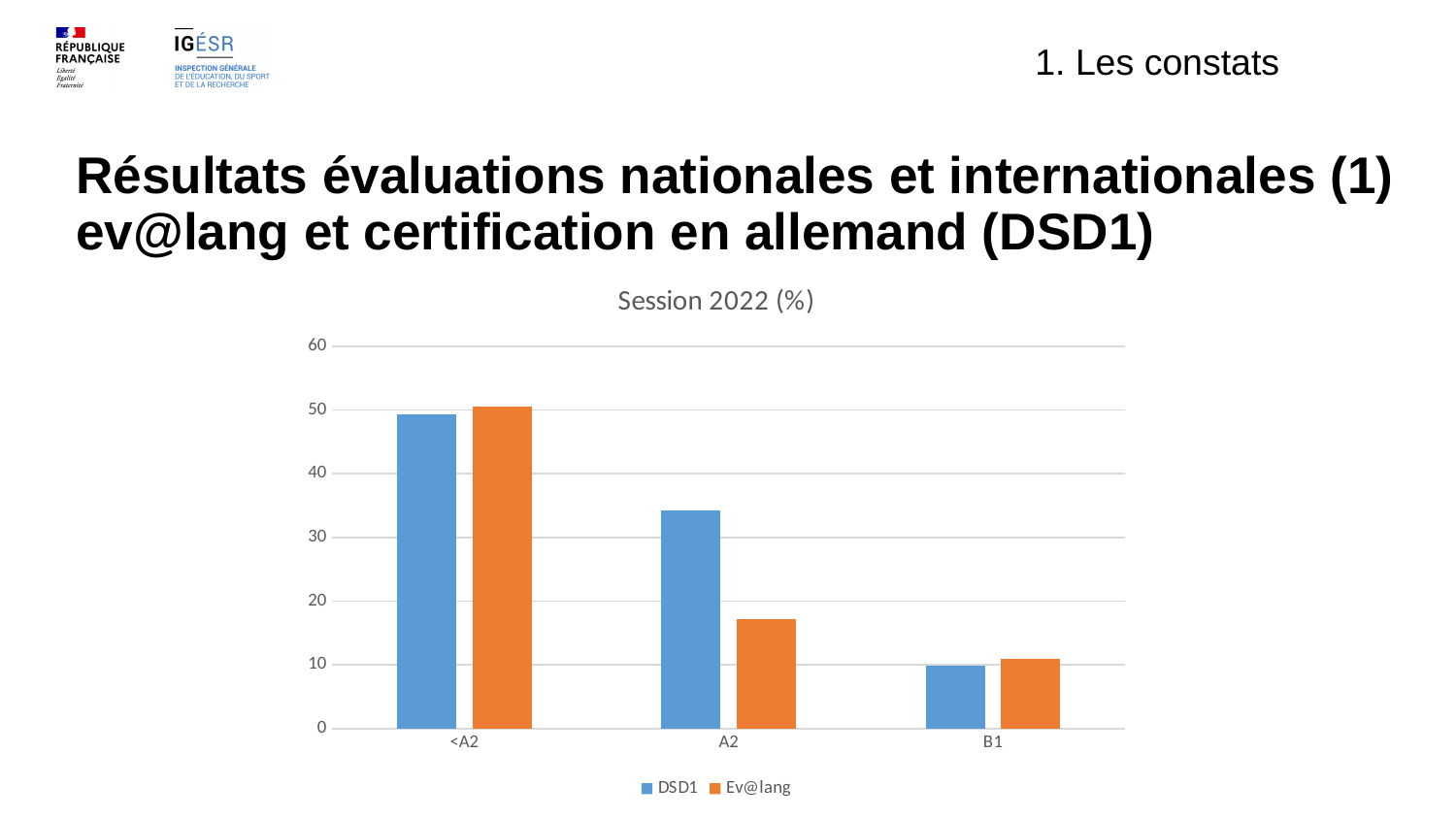
Do the DSD1 values rise or fall from <A2 to B1 along the x axis? fall Is the DSD1 value for A2 greater or less than 30? greater Is the DSD1 value for <A2 greater or less than 40? greater Is the Ev@lang value for A2 greater or less than 20? less How many categories are shown on the x axis of the chart? 3 What is the title of the chart? Session 2022 (%) How many series does the chart legend list? 2 For the DSD1 series, which category has the highest value? <A2 What kind of chart is shown on the slide? bar chart For the Ev@lang series, which category has the lowest value? B1 Which colour represents the Ev@lang series in the chart? orange In the A2 category, which series has the larger value, DSD1 or Ev@lang? DSD1